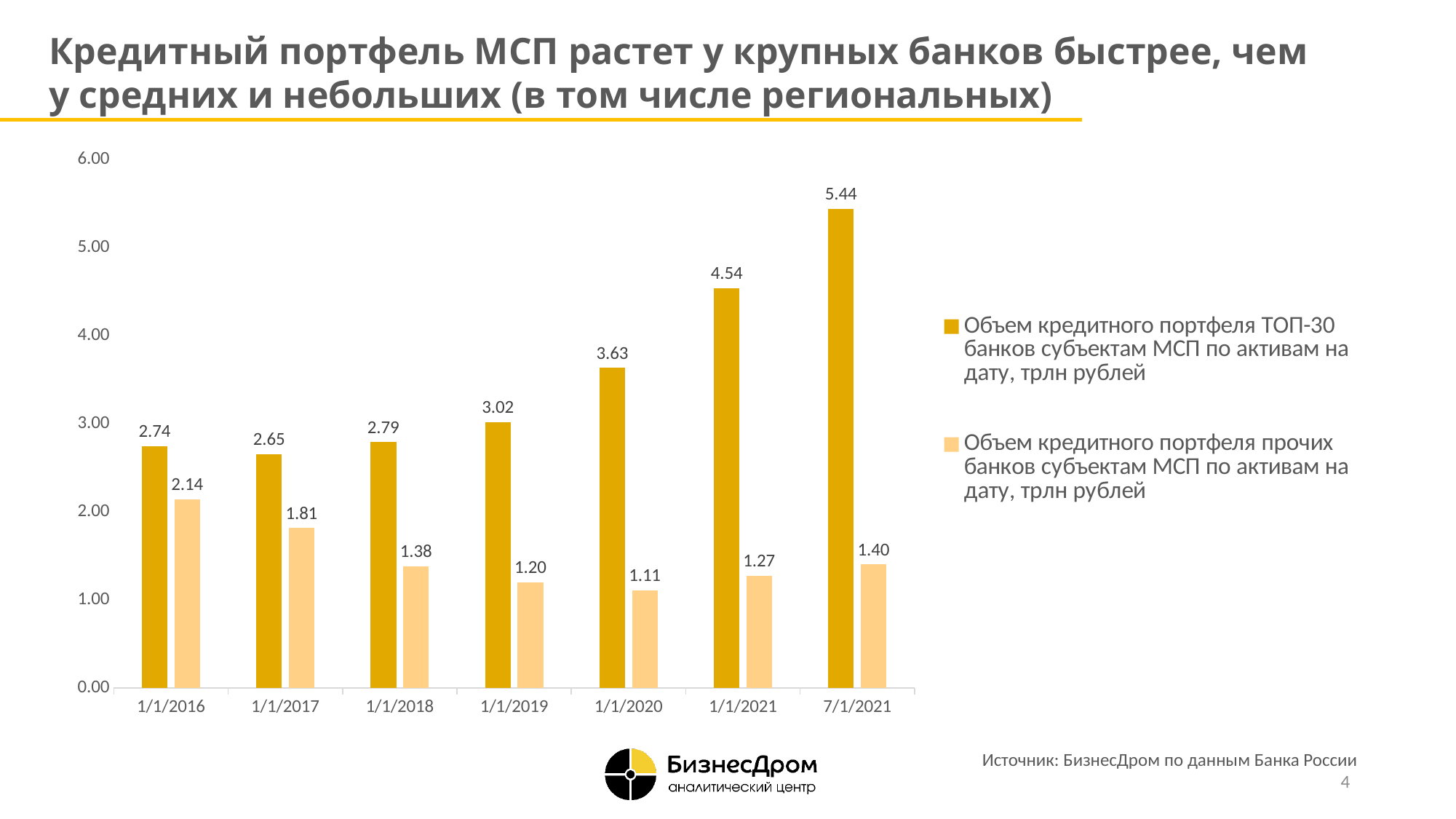
What is the value of the other banks' SME loan portfolio (Объем кредитного портфеля прочих банков) on 1/1/2018? 1.38 How many series does the legend list? 2 What kind of chart is shown on the slide? Bar chart What is the source cited for the chart data? БизнесДром по данным Банка России Does the TOP-30 banks' SME loan portfolio rise or fall from 1/1/2018 to 7/1/2021? Rise Which is larger on 1/1/2016: the TOP-30 banks' portfolio or the other banks' portfolio? TOP-30 banks' portfolio (2.74) What is the value of the TOP-30 banks' SME loan portfolio (Объем кредитного портфеля ТОП-30 банков) on 1/1/2020? 3.63 On which date is the other banks' SME loan portfolio lowest? 1/1/2020 How many dates are shown on the x axis of the chart? 7 Is the TOP-30 banks' SME loan portfolio on 1/1/2021 greater or less than 4.00? greater What is the difference between the TOP-30 banks' and the other banks' SME loan portfolio on 7/1/2021? 4.04 On which date is the TOP-30 banks' SME loan portfolio highest? 7/1/2021